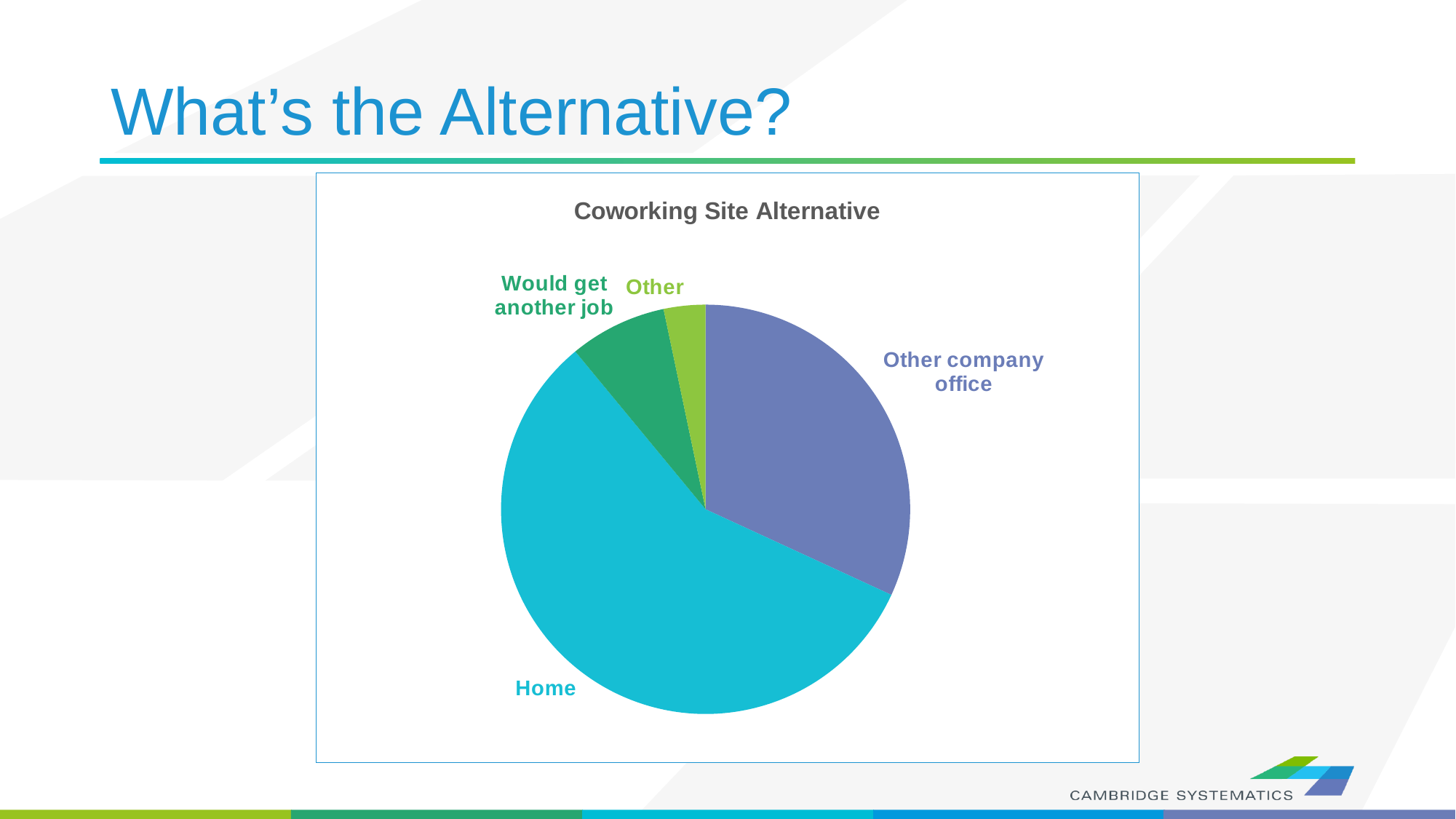
What colour is the Home slice? Teal Does the Home slice take up more or less than half of the pie? More Which slice is larger, Home or Other company office? Home How many slices does the pie chart have? 4 What is the title of the chart? Coworking Site Alternative Which category has the smallest slice of the pie? Other Which slice is larger, Other company office or Would get another job? Other company office Which category has the second-largest slice of the pie? Other company office What kind of chart is shown on the slide? Pie chart Which category has the largest slice of the pie? Home